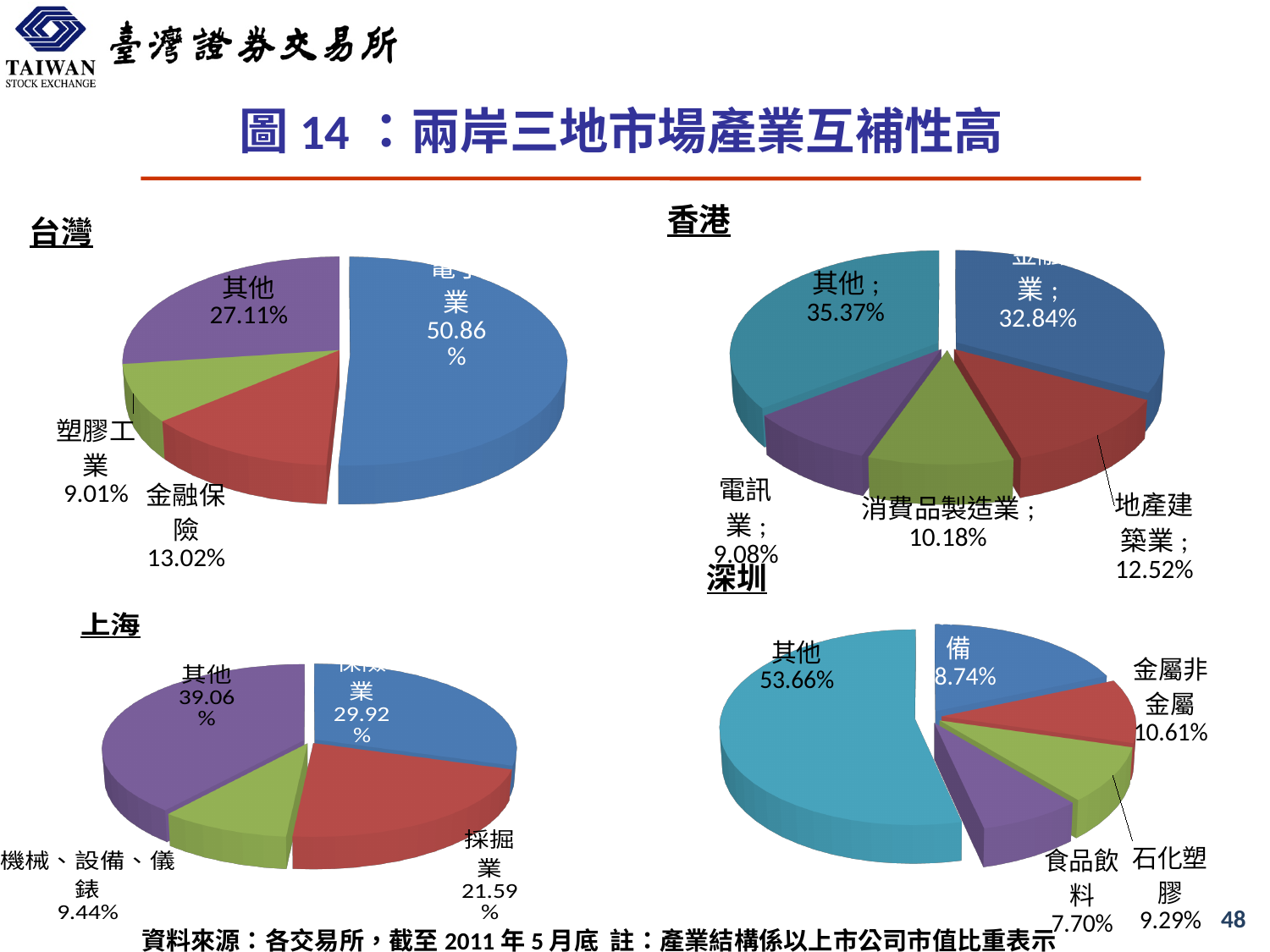
In the 深圳 pie chart, which category has the largest share? 其他 In the 香港 pie chart, what is the value for 地產建築業? 12.52% In the 上海 pie chart, what is the value for 機械、設備、儀錶? 9.44% In the 上海 pie chart, what is the value for 採掘業? 21.59% In the 香港 pie chart, what share does 其他 hold? 35.37% In the 香港 pie chart, what is the difference between 其他 and 地產建築業? 22.85% In the 台灣 pie chart, what is the value for 塑膠工業? 9.01% In the 台灣 pie chart, what share does 其他 hold? 27.11% In the 深圳 pie chart, what is the value for 食品飲料? 7.70% How many pie charts are shown on the slide? 4 In the 香港 pie chart, which is larger, 消費品製造業 or 電訊業? 消費品製造業 In the 台灣 pie chart, what is the value for 金融保險? 13.02%